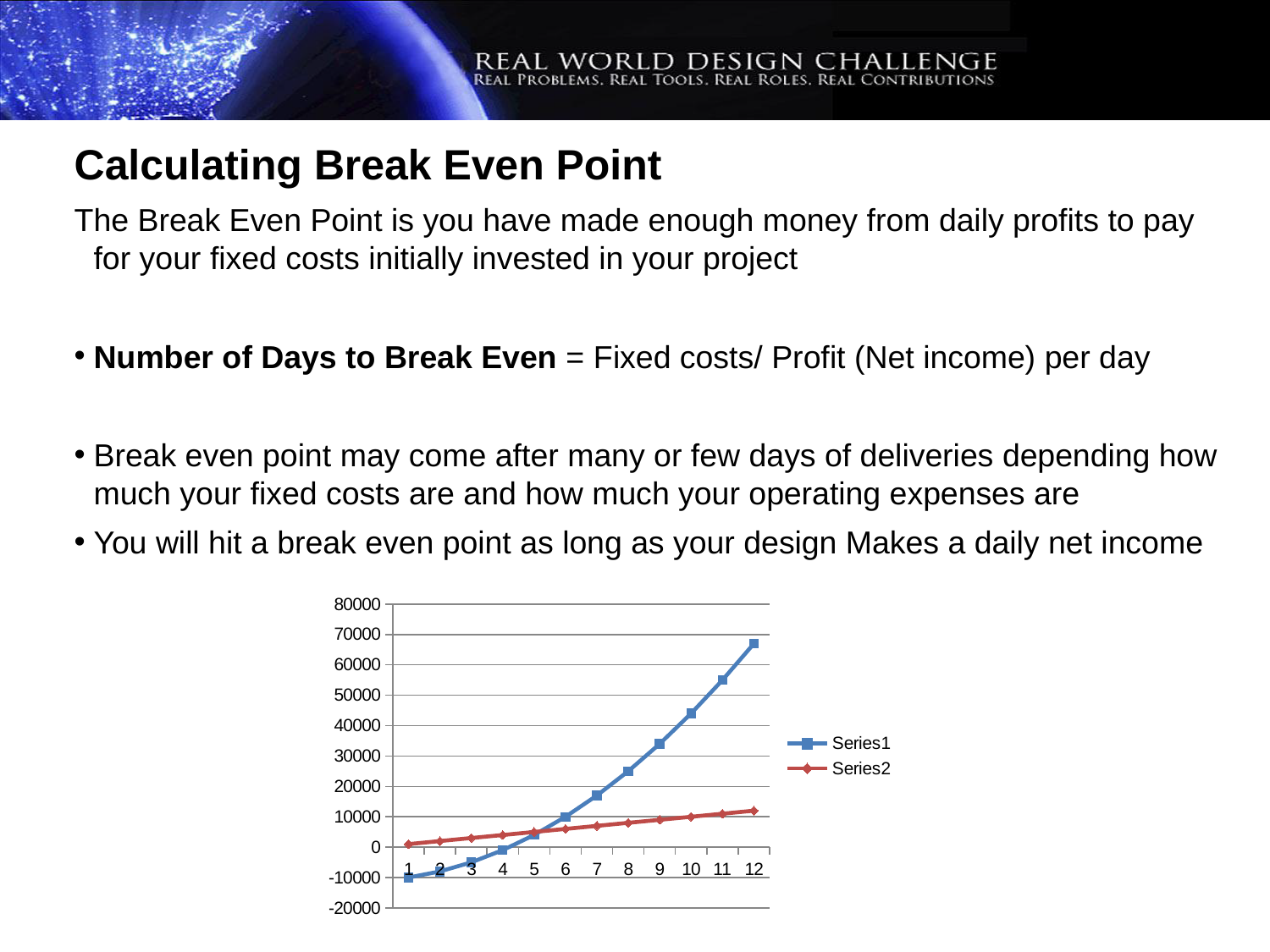
Which series has the higher value at x = 12? Series1 Is the value of Series1 at x = 9 greater or less than 30000? greater Is the value of Series2 at x = 12 greater or less than 20000? less Is the value of Series1 at x = 12 greater or less than 60000? greater What colour is the line for Series2? red How many points are plotted along the x axis for each series? 12 Which series has the higher value at x = 2? Series2 How many series does the chart legend list? 2 At which x value does Series1 reach its highest point? 12 What kind of chart is shown on the slide? line chart Do the values of Series1 rise or fall as x increases from 1 to 12? rise